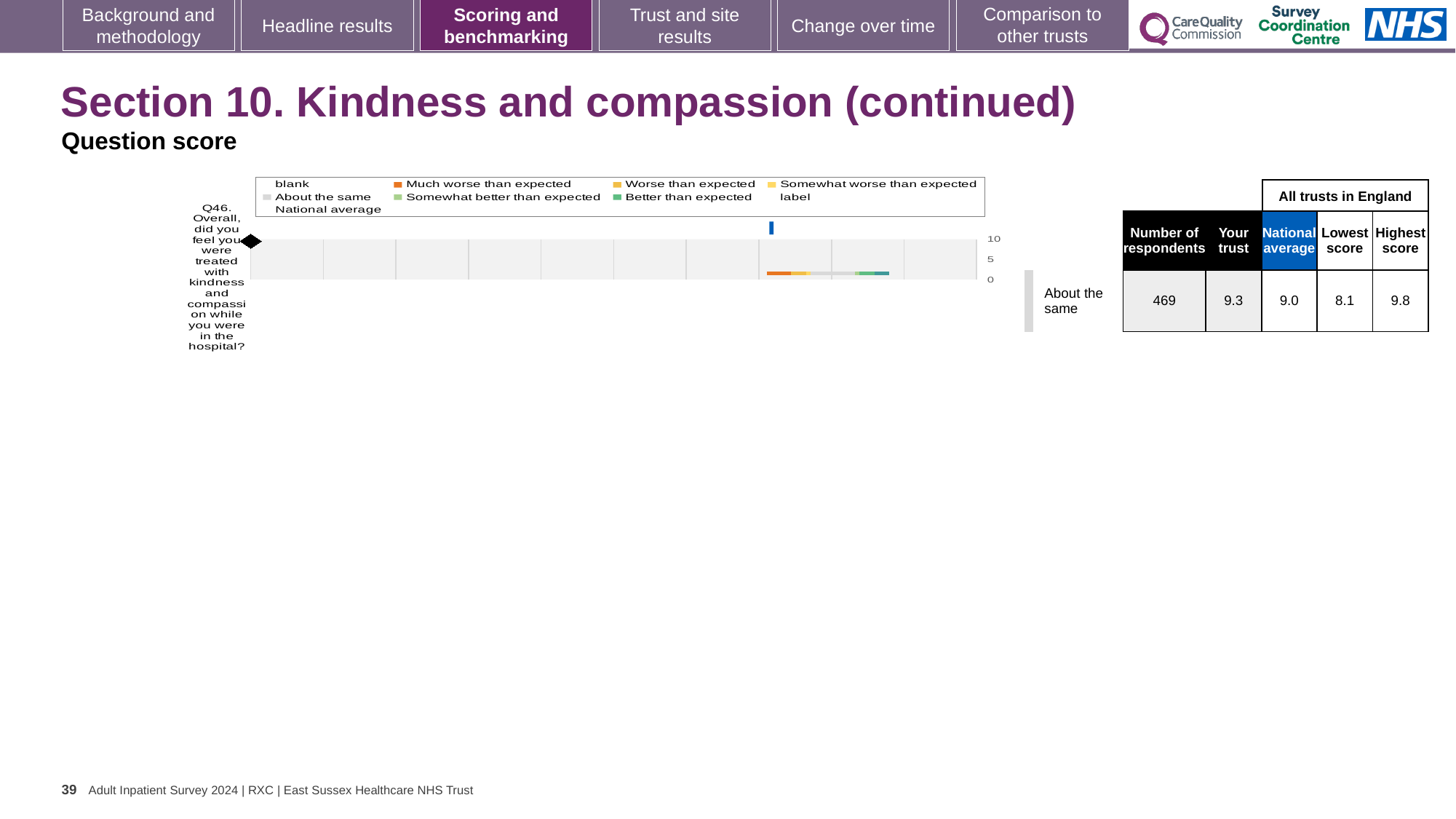
What is the 'Your trust' score for Q46 shown on the slide? 9.3 What is the highest tick value shown on the chart's axis? 10 What kind of chart is shown on the slide? bar chart Which is larger for Q46: the 'Your trust' score or the national average? Your trust How many respondents answered Q46? 469 What is the difference between the highest score and the lowest score for Q46? 1.7 What is the national average score for Q46 shown on the slide? 9.0 How many questions (categories) are plotted on the chart? 1 Is the plotted value for Q46 greater or less than 5 on the chart's axis? greater What is the lowest score among all trusts in England for Q46? 8.1 Which benchmark category is the trust's Q46 result labelled as on the slide? About the same What is the highest score among all trusts in England for Q46? 9.8